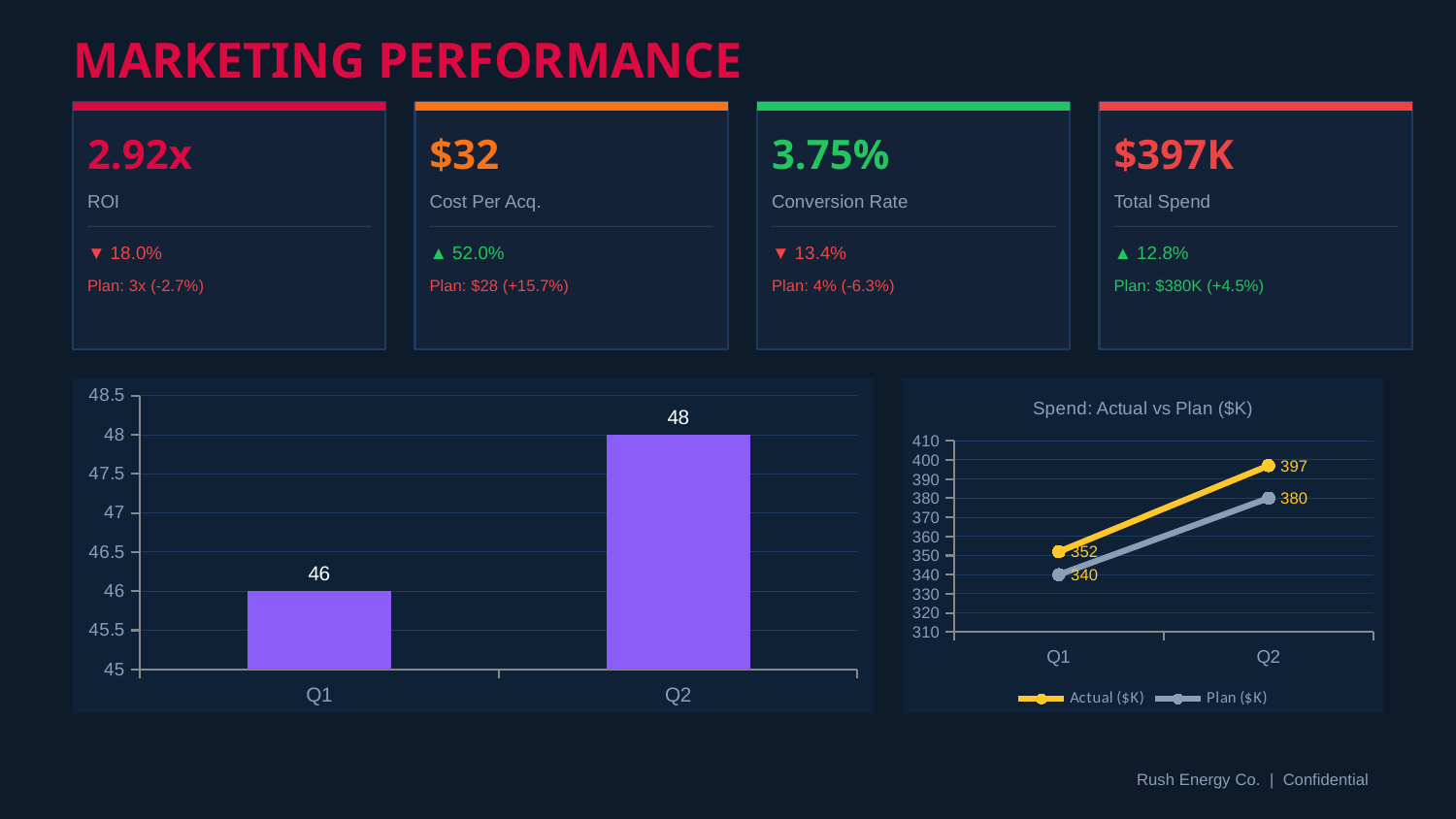
In the bar chart on the left of the slide, what is the value for Q1? 46 What kind of chart is the 'Spend: Actual vs Plan ($K)' chart? Line chart In the 'Spend: Actual vs Plan ($K)' chart, does the Actual series rise or fall from Q1 to Q2? Rise In the bar chart on the left of the slide, what is the value for Q2? 48 In the 'Spend: Actual vs Plan ($K)' chart, what is the Plan value for Q1? 340 In the 'Spend: Actual vs Plan ($K)' chart, what is the difference between the Actual and Plan values in Q2? 17 In the bar chart on the left of the slide, which quarter has the higher value? Q2 What kind of chart is the chart on the left of the slide? Bar chart How many series does the legend of the 'Spend: Actual vs Plan ($K)' chart list? 2 In the 'Spend: Actual vs Plan ($K)' chart, which is larger in Q1, Actual or Plan? Actual In the 'Spend: Actual vs Plan ($K)' chart, what is the Actual value for Q2? 397 In the bar chart on the left of the slide, what is the difference between the Q2 and Q1 values? 2